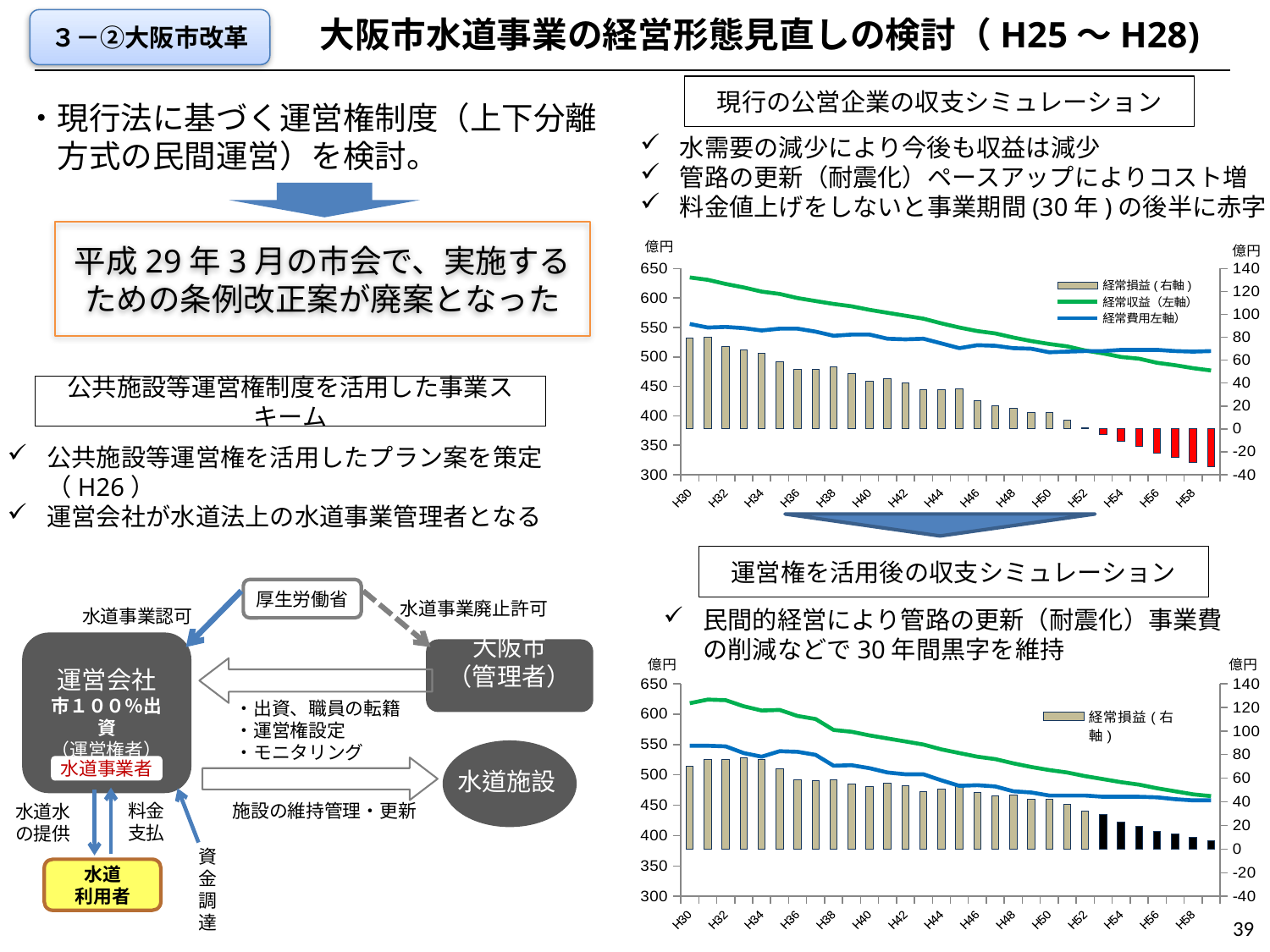
How many series does the legend of the top chart (現行の公営企業の収支シミュレーション) list? 3 In the top chart (現行の公営企業の収支シミュレーション), is the 経常損益 value for H58 greater or less than 0? less In the top chart (現行の公営企業の収支シミュレーション), is the 経常収益 value for H30 greater or less than 600? greater In the bottom chart (運営権を活用後の収支シミュレーション), is the 経常損益 value for H58 greater or less than 0? greater What is the only legend entry shown in the bottom chart (運営権を活用後の収支シミュレーション)? 経常損益(右軸) What kind of chart is the top chart titled 現行の公営企業の収支シミュレーション? A combined bar and line chart In the bottom chart (運営権を活用後の収支シミュレーション), does the green line rise or fall from H30 to H58? Fall In the top chart (現行の公営企業の収支シミュレーション), which is larger at H58, 経常収益 or 経常費用? 経常費用 In the top chart (現行の公営企業の収支シミュレーション), which is larger at H30, 経常収益 or 経常費用? 経常収益 In the top chart (現行の公営企業の収支シミュレーション), does the 経常収益 line rise or fall from H30 to H58? Fall